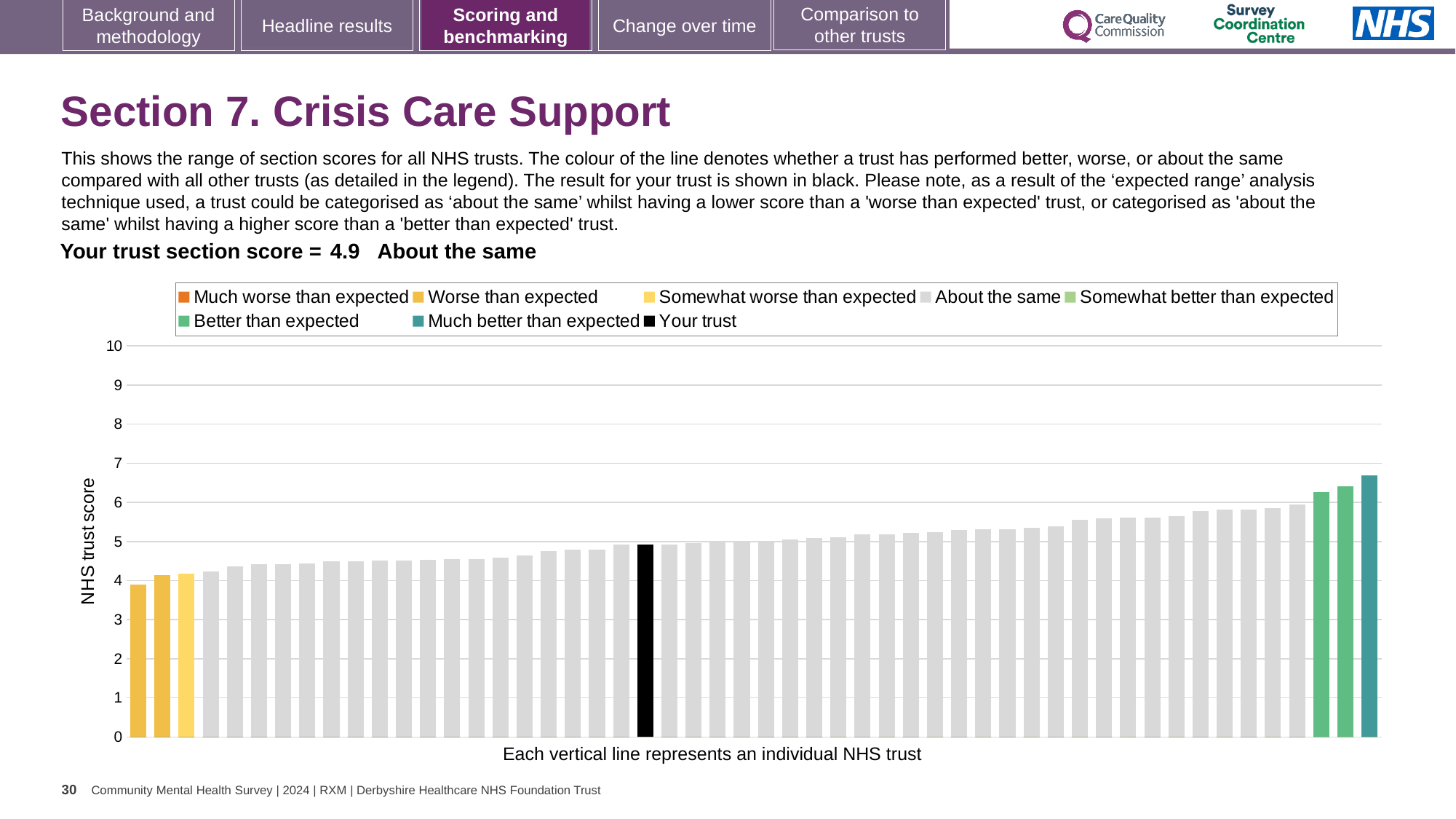
Do the bar values rise or fall from left to right along the x axis? rise What is the label on the vertical axis of the chart? NHS trust score Is the value for your trust greater or less than 5? less How many bars are coloured as 'Worse than expected'? 2 What colour is the bar representing your trust? black What is the section score for your trust? 4.9 Is the value of the lowest bar greater or less than 5? less What kind of chart is shown on the slide? bar chart How many entries does the chart legend list? 8 Is the value of the highest bar greater or less than 6? greater Which category is your trust placed in for this section? About the same How many bars are coloured as 'Much better than expected'? 1